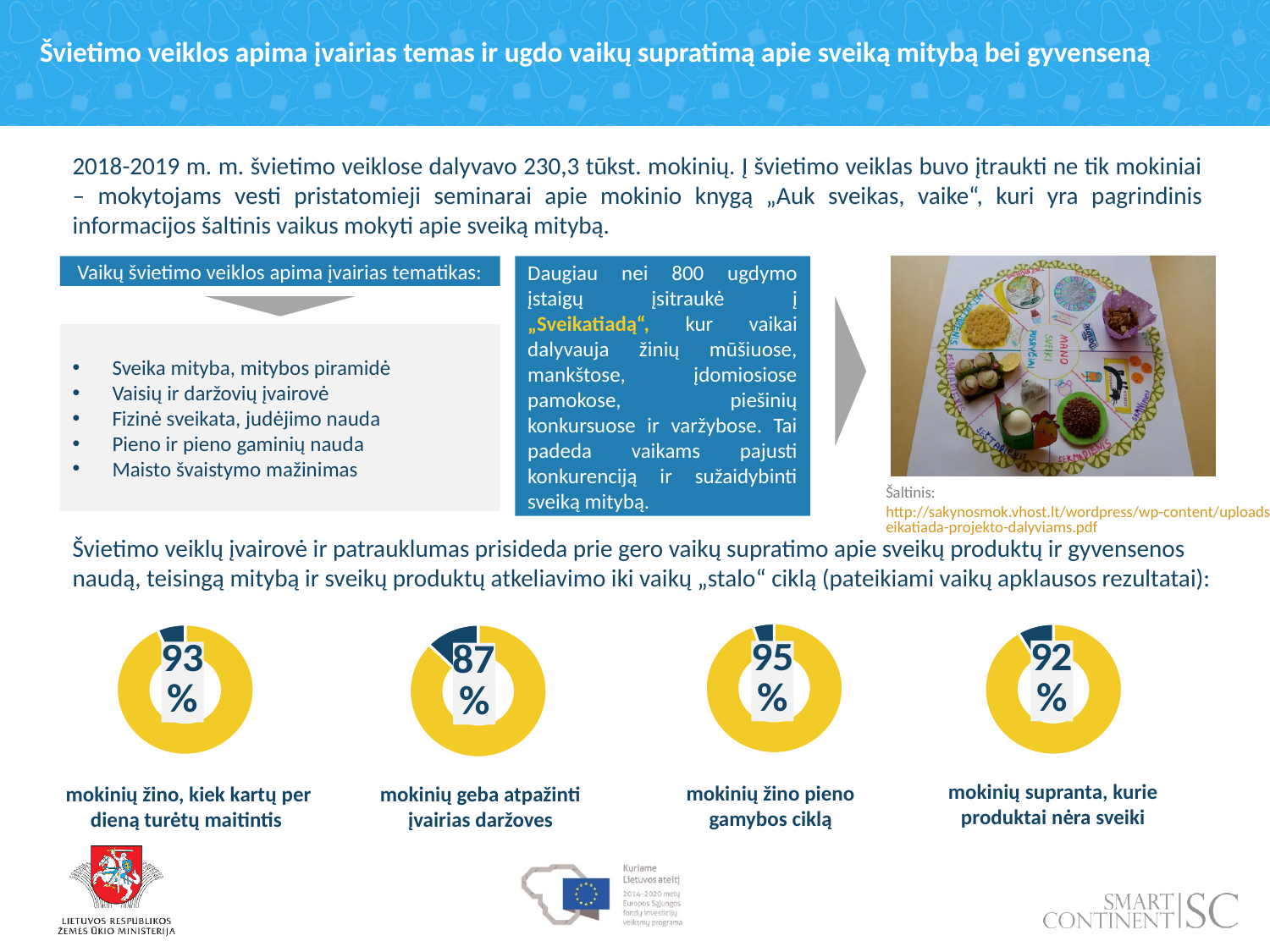
What kind of chart is used to display the survey results at the bottom of the slide? Donut (pie) chart What percentage is shown in the donut chart labelled "mokinių žino, kiek kartų per dieną turėtų maitintis"? 93 % What percentage is shown in the donut chart labelled "mokinių žino pieno gamybos ciklą"? 95 % What is the difference between the percentage for "mokinių žino, kiek kartų per dieną turėtų maitintis" and the percentage for "mokinių supranta, kurie produktai nėra sveiki"? 1 % In the donut chart labelled "mokinių geba atpažinti įvairias daržoves", what share of the ring is coloured yellow? 87 % Which of the four donut charts at the bottom of the slide shows the highest percentage? mokinių žino pieno gamybos ciklą (95 %) How many donut charts are shown at the bottom of the slide? 4 Which is larger: the percentage for "mokinių žino, kiek kartų per dieną turėtų maitintis" or the percentage for "mokinių supranta, kurie produktai nėra sveiki"? mokinių žino, kiek kartų per dieną turėtų maitintis (93 %) What percentage is shown in the donut chart labelled "mokinių supranta, kurie produktai nėra sveiki"? 92 % What is the difference between the percentage for "mokinių žino pieno gamybos ciklą" and the percentage for "mokinių geba atpažinti įvairias daržoves"? 8 % What percentage is shown in the donut chart labelled "mokinių geba atpažinti įvairias daržoves"? 87 % Which of the four donut charts at the bottom of the slide shows the lowest percentage? mokinių geba atpažinti įvairias daržoves (87 %)